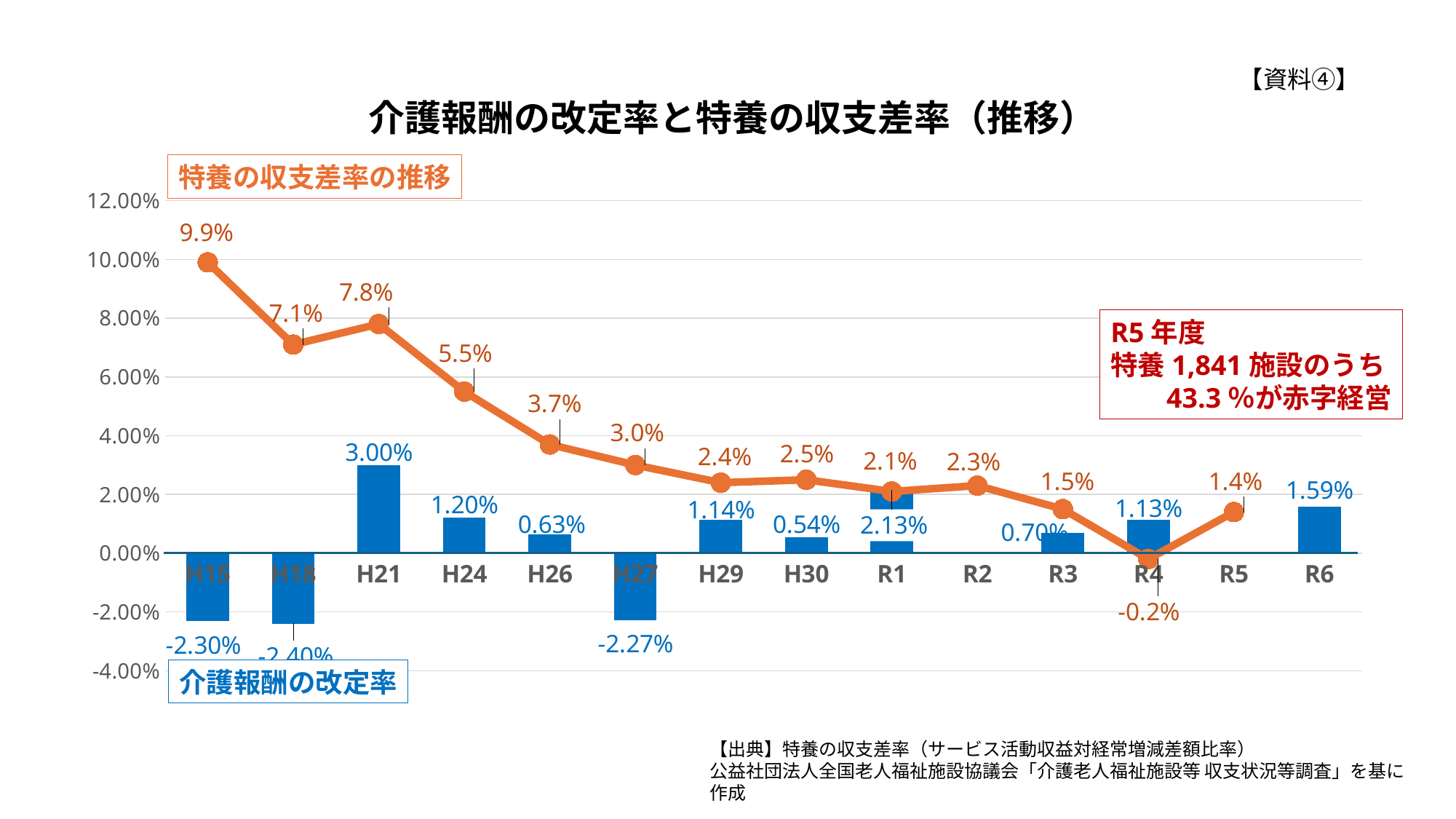
What is the 特養の収支差率 value for R4? -0.2% What is the difference between the 特養の収支差率 values for H15 and H18? 2.8% How many year categories are shown on the x axis? 14 Overall, does the 特養の収支差率 line rise or fall from H15 to R5? fall In which year is the 特養の収支差率 line at its highest? H15 What colour is the 特養の収支差率の推移 line? orange What is the 特養の収支差率 value for H15? 9.9% Which year has the lowest 介護報酬の改定率 bar? H18 Which is larger, the 介護報酬の改定率 for H24 or for H29? H24 What is the 介護報酬の改定率 value for H21? 3.00% In which year is the 特養の収支差率 line at its lowest? R4 What is the 介護報酬の改定率 value for R6? 1.59%